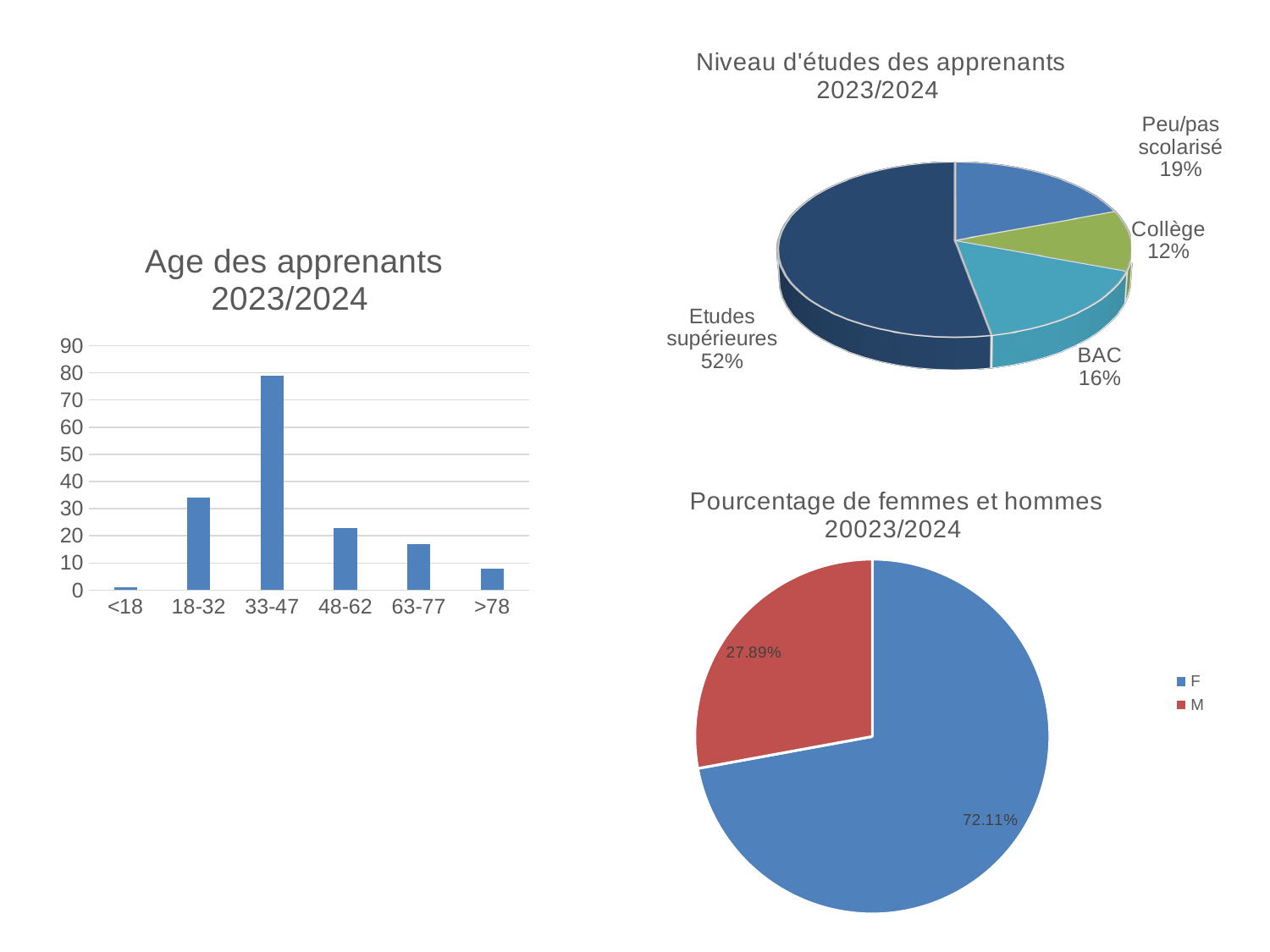
How many series does the legend of the 'Pourcentage de femmes et hommes' chart list? 2 How many age groups are shown in the 'Age des apprenants 2023/2024' chart? 6 What kind of chart is 'Age des apprenants 2023/2024'? bar chart In the 'Niveau d'études des apprenants 2023/2024' chart, what share is 'Etudes supérieures'? 52% In the 'Age des apprenants 2023/2024' chart, which is larger, the value for 48-62 or the value for 63-77? 48-62 In the 'Niveau d'études des apprenants 2023/2024' chart, what share is 'Collège'? 12% In the 'Pourcentage de femmes et hommes' chart, what share is M? 27.89% In the 'Niveau d'études des apprenants 2023/2024' chart, what is the difference between the 'Peu/pas scolarisé' share and the 'BAC' share? 3% In the 'Age des apprenants 2023/2024' chart, is the value for 18-32 greater or less than 40? less In the 'Age des apprenants 2023/2024' chart, which age group has the highest value? 33-47 In the 'Age des apprenants 2023/2024' chart, which age group has the lowest value? <18 In the 'Age des apprenants 2023/2024' chart, is the value for 33-47 greater or less than 70? greater